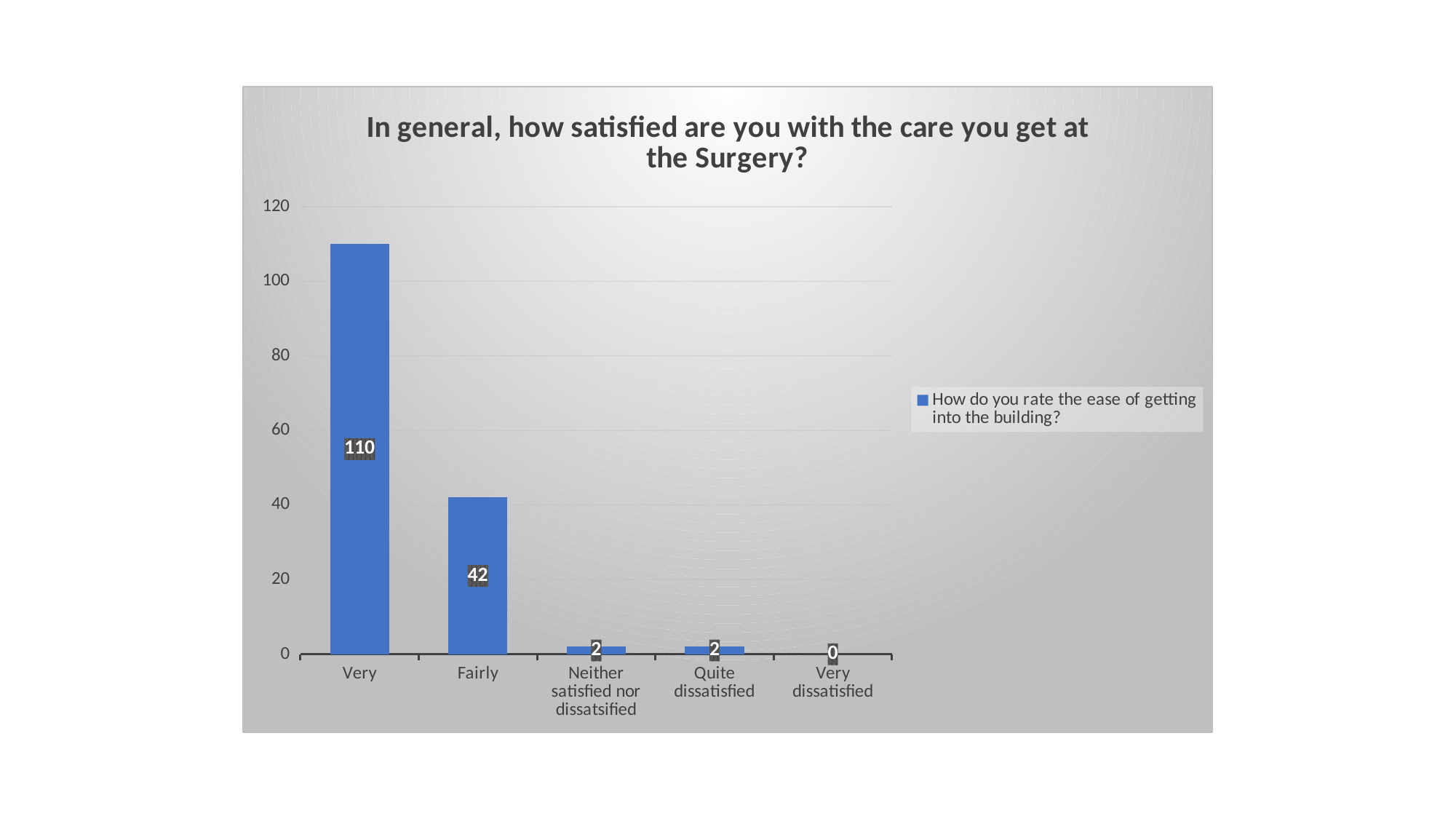
Which category has the highest value? Very How many categories are shown on the x axis? 5 What is the difference between the values for "Very" and "Fairly"? 68 What is the value for "Quite dissatisfied"? 2 Which is larger, the value for "Fairly" or the value for "Neither satisfied nor dissatsified"? Fairly What is the value for "Very dissatisfied"? 0 Which category has the lowest value? Very dissatisfied Is the value for "Very" greater or less than 100? greater What kind of chart is shown on the slide? Bar chart What is the value for the "Very" category? 110 What is the value for the "Fairly" category? 42 What is the title of the chart? In general, how satisfied are you with the care you get at the Surgery?